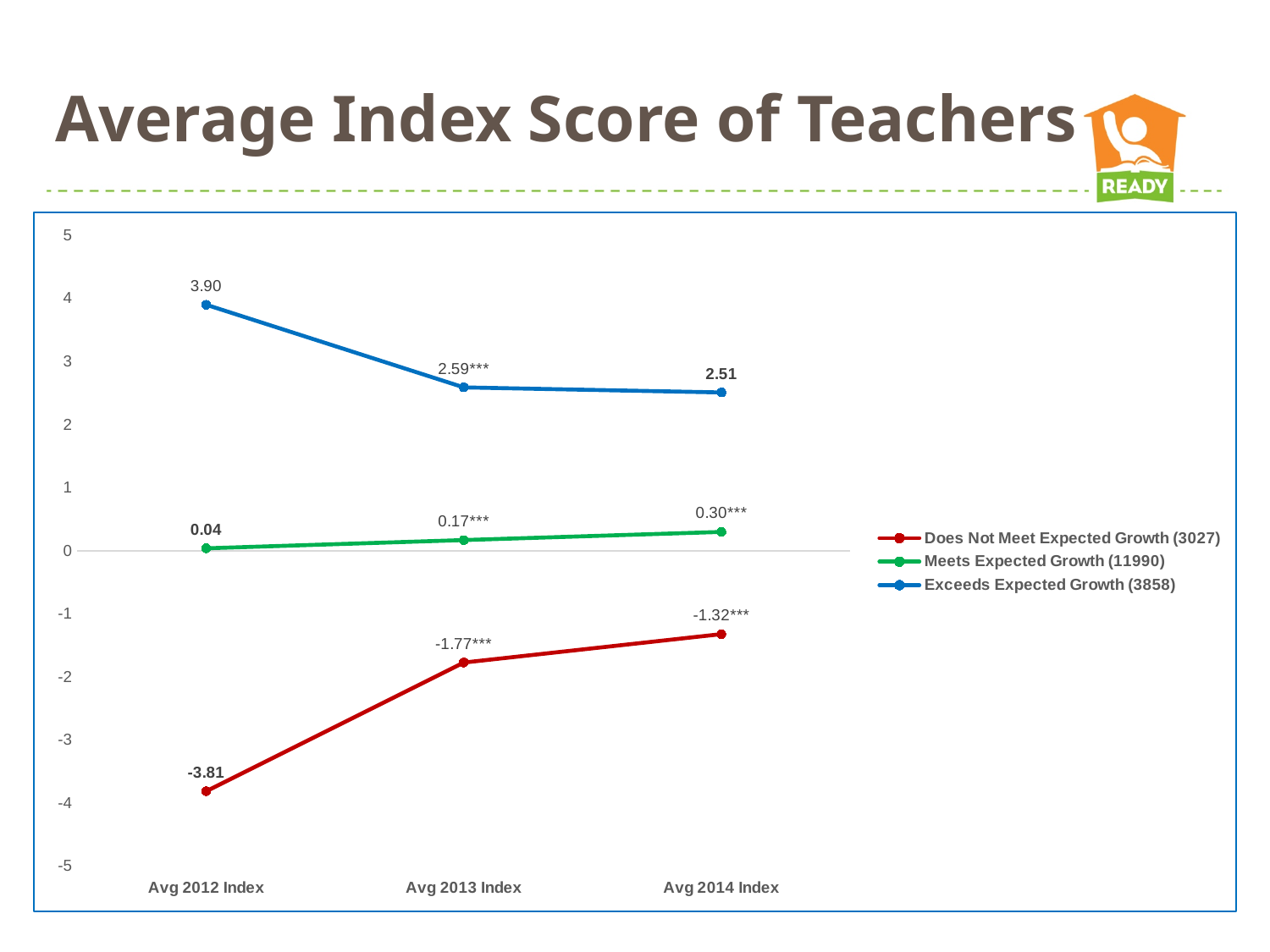
Does the Exceeds Expected Growth series rise or fall from Avg 2012 Index to Avg 2014 Index? fall What is the value for Does Not Meet Expected Growth at Avg 2013 Index? -1.77*** What is the value for Meets Expected Growth at Avg 2014 Index? 0.30*** Which series has the highest value at Avg 2014 Index? Exceeds Expected Growth (3858) Does the Does Not Meet Expected Growth series rise or fall from Avg 2012 Index to Avg 2014 Index? rise What is the value for Exceeds Expected Growth at Avg 2012 Index? 3.90 What is the title of the chart? Average Index Score of Teachers Which series has the lowest value at Avg 2012 Index? Does Not Meet Expected Growth (3027) How many series does the legend list? 3 How many points are plotted along the x axis for each series? 3 What kind of chart is shown on the slide? line chart Which is larger for Exceeds Expected Growth: the value at Avg 2012 Index or at Avg 2014 Index? Avg 2012 Index